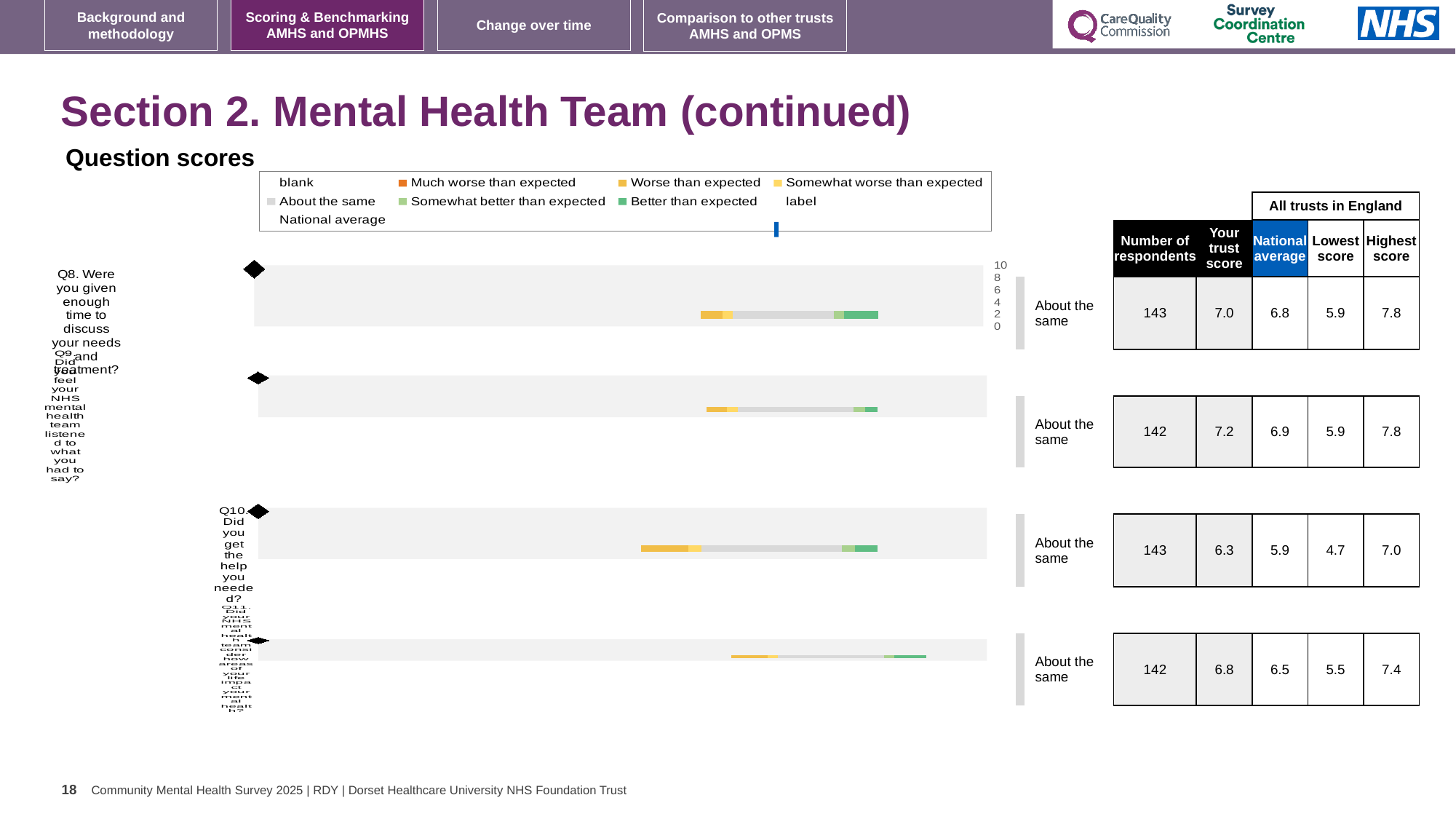
For Q8, which is larger: the trust score or the national average? the trust score What kind of chart is used to show the question scores for Q8 to Q11? bar chart Which question has the highest 'Your trust score' on the slide? Q9 What is the 'Your trust score' value shown for Q8 (Were you given enough time to discuss your needs and treatment?)? 7.0 What is the number of respondents shown for Q10 (Did you get the help you needed?)? 143 What is the difference between the trust score and the national average for Q10? 0.4 What benchmark category label is shown next to the Q9 chart? About the same What colour in the legend represents 'Better than expected'? green Which question has the lowest 'Your trust score' on the slide? Q10 What is the national average shown for Q9 (Did you feel your NHS mental health team listened to what you had to say?)? 6.9 What is the highest score across all trusts in England shown for Q11? 7.4 How many question charts (Q8 to Q11) are shown on the slide? 4